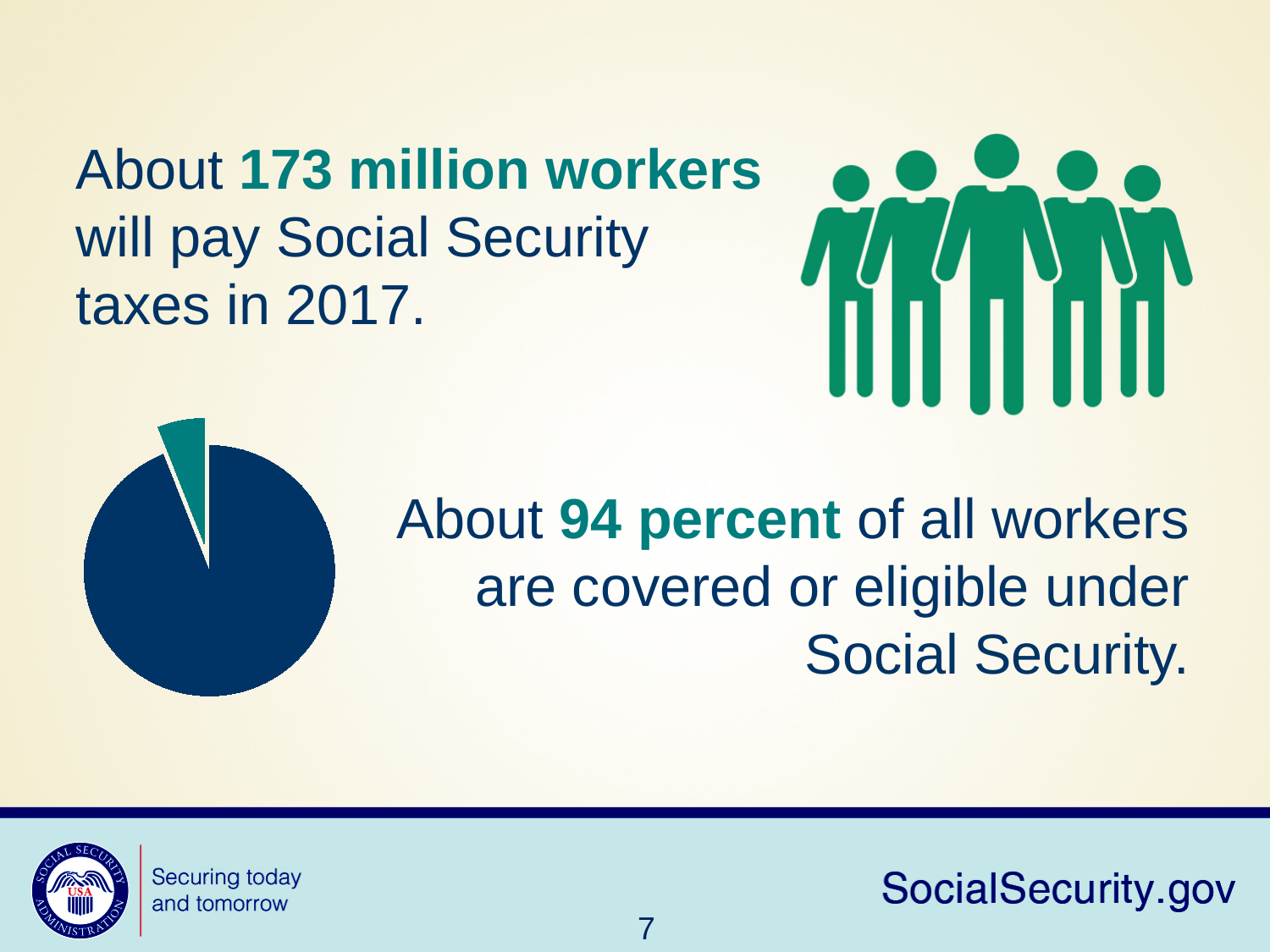
Does the pie chart have a legend? No Which slice of the pie chart is the smallest? the teal slice What colour is the small exploded slice of the pie chart? teal How many slices does the pie chart have? 2 What kind of chart is shown on the slide? pie chart Which slice of the pie chart is larger, the dark blue slice or the teal slice? the dark blue slice Does the dark blue slice of the pie chart represent more or less than half of the pie? more